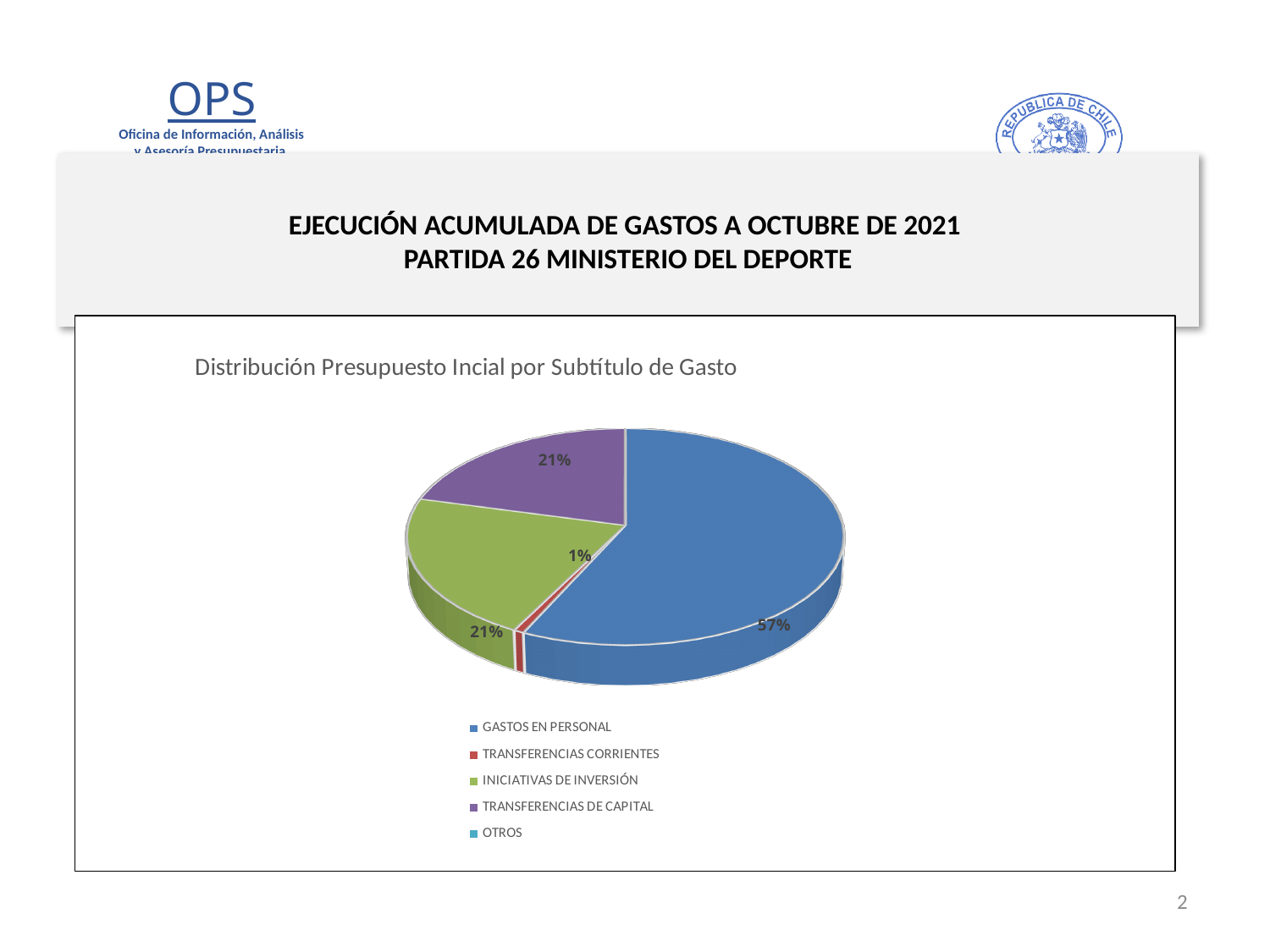
What kind of chart is shown on the slide? Pie chart What percentage is shown for TRANSFERENCIAS DE CAPITAL? 21% What share of the pie does GASTOS EN PERSONAL represent? 57% What is the combined share of INICIATIVAS DE INVERSIÓN and TRANSFERENCIAS DE CAPITAL? 42% What is the title of the chart? Distribución Presupuesto Incial por Subtítulo de Gasto How many categories does the legend list? 5 What percentage is shown for TRANSFERENCIAS CORRIENTES? 1% Which is larger, GASTOS EN PERSONAL or INICIATIVAS DE INVERSIÓN? GASTOS EN PERSONAL What is the difference in percentage points between GASTOS EN PERSONAL and TRANSFERENCIAS DE CAPITAL? 36 percentage points Which is larger, TRANSFERENCIAS DE CAPITAL or TRANSFERENCIAS CORRIENTES? TRANSFERENCIAS DE CAPITAL What percentage is shown for INICIATIVAS DE INVERSIÓN? 21% Which category has the largest slice of the pie? GASTOS EN PERSONAL